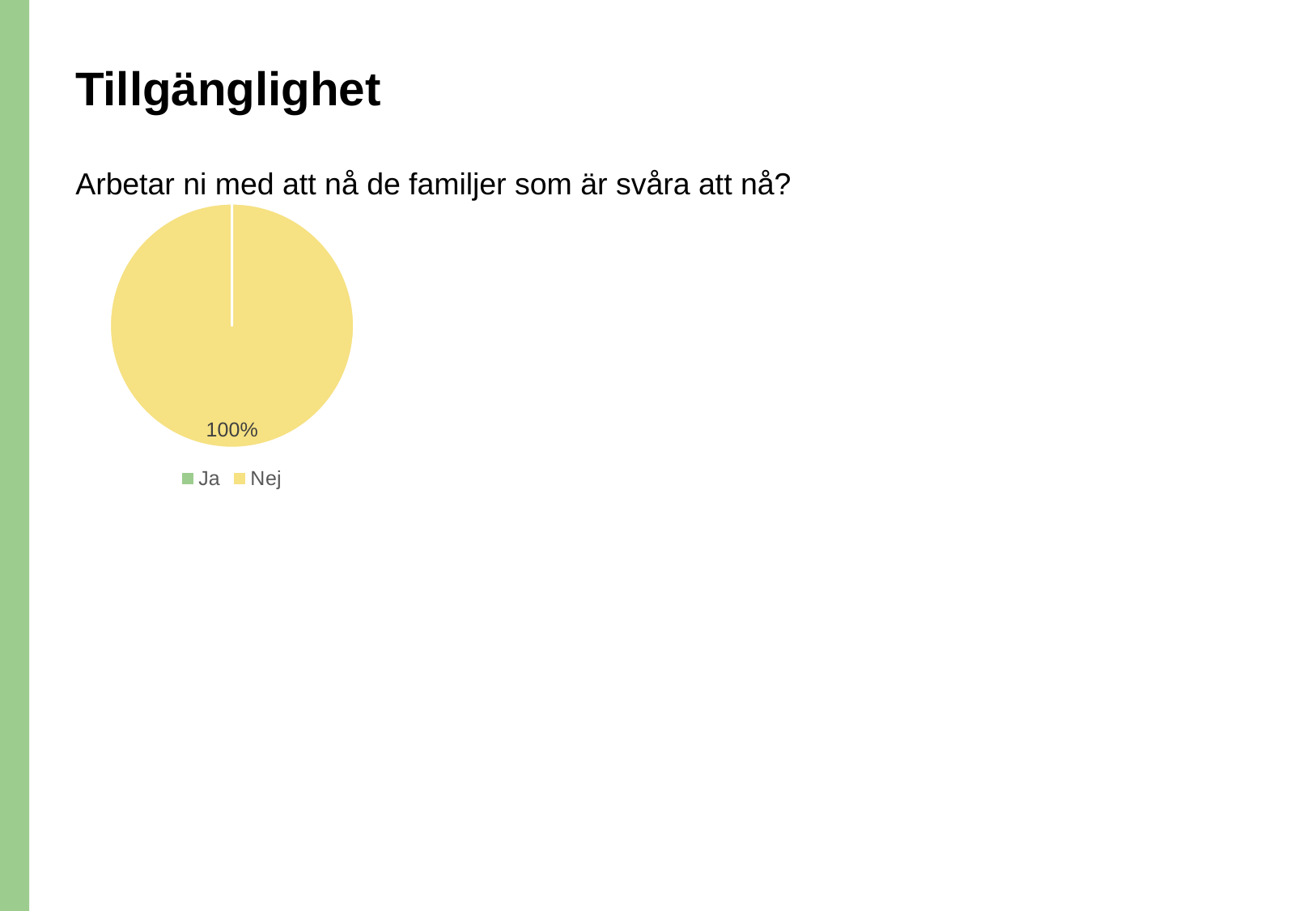
Which category has the smaller share of the pie, Ja or Nej? Ja What is the only percentage label printed on the pie chart? 100% What are the two categories listed in the legend? Ja and Nej Which category has the largest share of the pie? Nej What share of the pie does Nej account for? 100% What colour represents Nej in the pie chart? yellow How many categories does the legend list? 2 What kind of chart is shown on the slide? pie chart